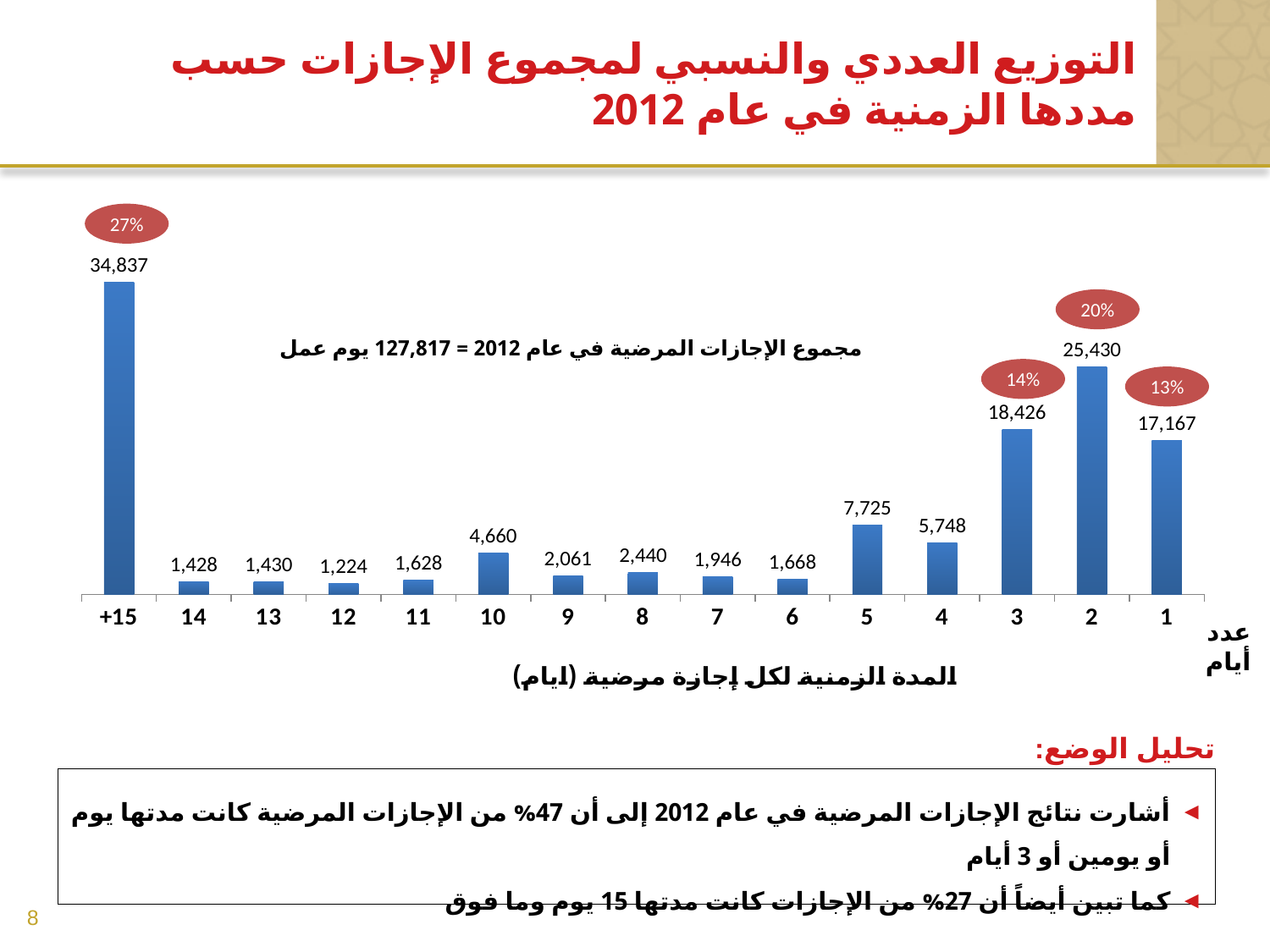
What percentage label is shown above the bar for 2 days? 20% What total number of sick leave days in 2012 is stated in the text inside the chart? 127,817 What is the number of sick leave days for leaves lasting 2 days? 25,430 Which is larger, the value for 5 days or the value for 4 days? 5 days What is the difference between the values for 3 days and 1 day? 1,259 Which duration category has the highest value? +15 What percentage label is shown above the bar for 3 days? 14% What value is shown for the +15 days category? 34,837 What is the value for leaves lasting 10 days? 4,660 What type of chart is shown on the slide? Bar chart How many duration categories are shown on the x axis? 15 Which duration category has the lowest value? 12